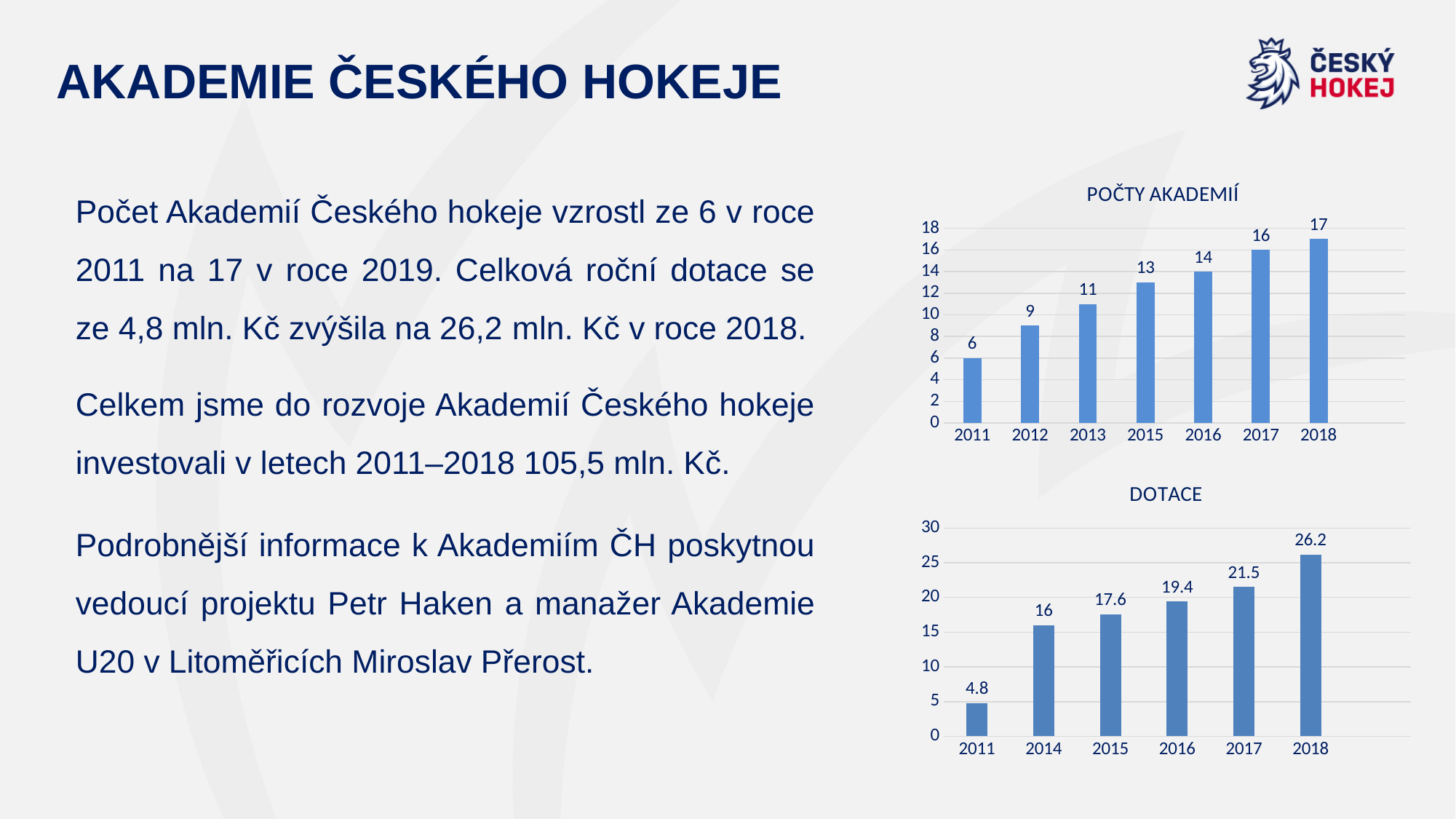
In the DOTACE chart, which year has the highest value? 2018 In the POČTY AKADEMIÍ chart, how many years are shown on the x axis? 7 In the POČTY AKADEMIÍ chart, do the values rise or fall from 2011 to 2018? rise In the POČTY AKADEMIÍ chart, which year has the lowest value? 2011 In the DOTACE chart, is the value for 2015 larger than the value for 2014? Yes In the POČTY AKADEMIÍ chart, what is the difference between the values for 2018 and 2011? 11 In the POČTY AKADEMIÍ chart, what is the value for 2013? 11 In the DOTACE chart, what is the difference between the values for 2018 and 2017? 4.7 In the POČTY AKADEMIÍ chart, which year has the highest value? 2018 What kind of chart is the DOTACE chart? Bar chart In the DOTACE chart, what is the value for 2016? 19.4 In the DOTACE chart, what is the value for 2011? 4.8